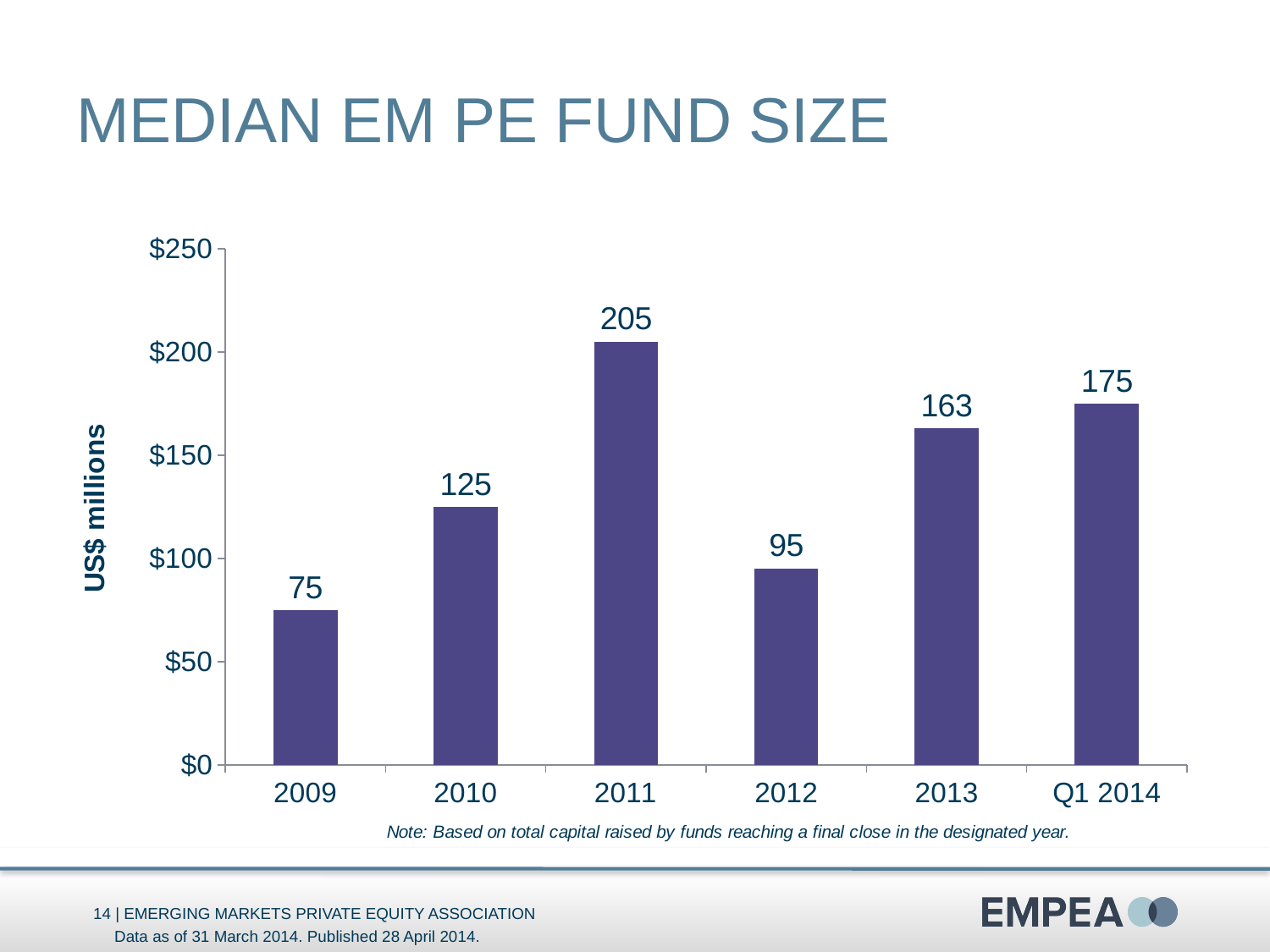
Which is larger, the median fund size in 2010 or in 2012? 2010 How many periods are shown on the x axis of the chart? 6 Which year has the lowest median EM PE fund size? 2009 What is the difference between the median fund size in Q1 2014 and in 2013? 12 Is the median fund size for 2013 greater or less than $150 million? greater What is the median EM PE fund size for Q1 2014? 175 What is the difference between the median fund size in 2011 and in 2012? 110 Which year has the highest median EM PE fund size? 2011 What is the median EM PE fund size for 2009? 75 What is the median EM PE fund size for 2011? 205 What kind of chart is shown on the slide? bar chart What is the label of the vertical axis of the chart? US$ millions